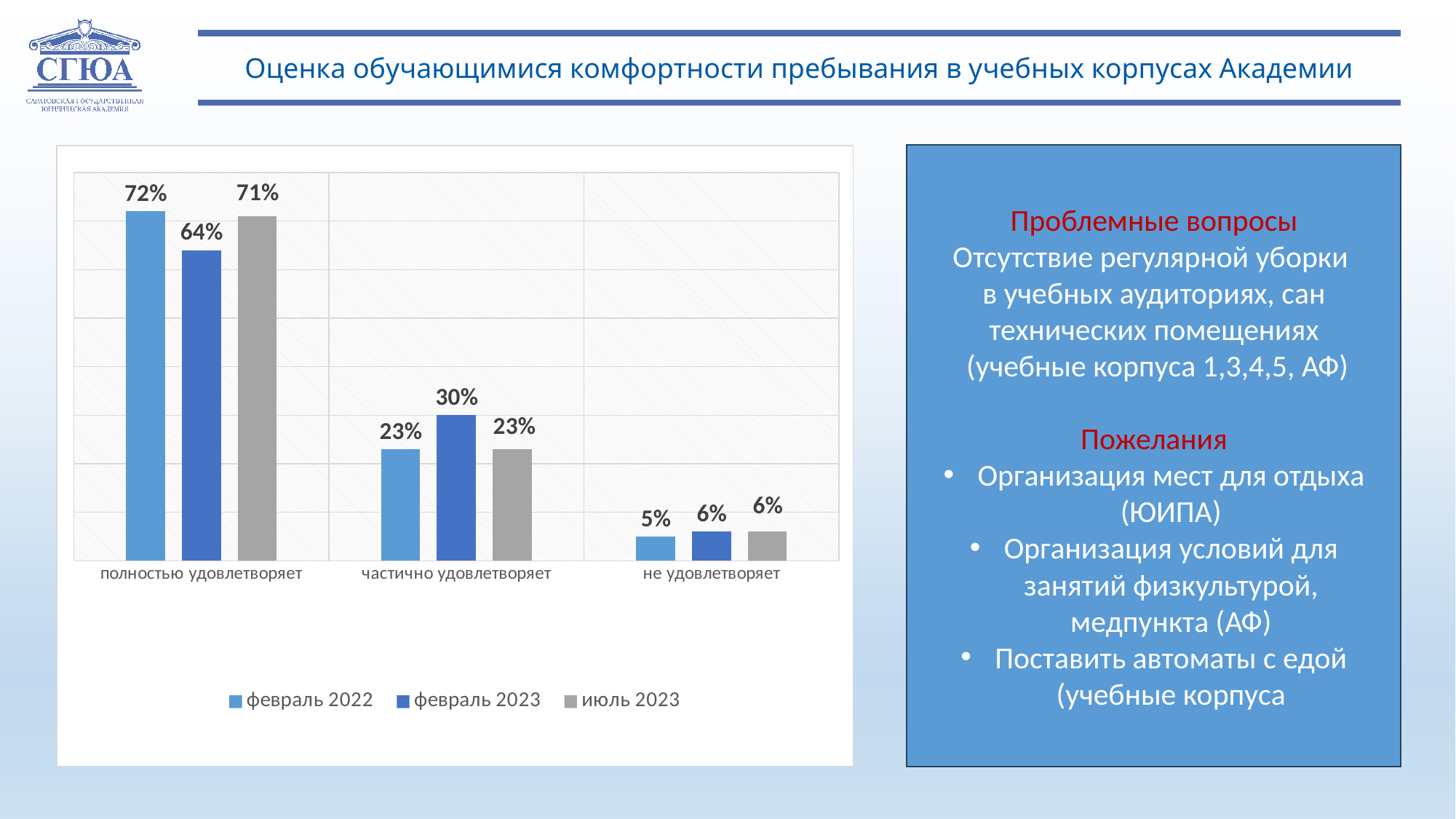
What is the value for 'частично удовлетворяет' in the 'февраль 2023' series? 30% Which is larger for 'частично удовлетворяет': the 'февраль 2023' value or the 'июль 2023' value? февраль 2023 Which series is shown in grey in the legend? июль 2023 What is the value for 'не удовлетворяет' in the 'июль 2023' series? 6% Which category has the highest value in the 'февраль 2023' series? полностью удовлетворяет Which category has the lowest value in the 'февраль 2022' series? не удовлетворяет What is the value for 'полностью удовлетворяет' in the 'февраль 2022' series? 72% How many categories are shown on the x axis? 3 What kind of chart is shown on the slide? bar chart How many series does the legend list? 3 What is the difference between the 'февраль 2022' and 'февраль 2023' values for 'полностью удовлетворяет'? 8% What is the value for 'полностью удовлетворяет' in the 'июль 2023' series? 71%